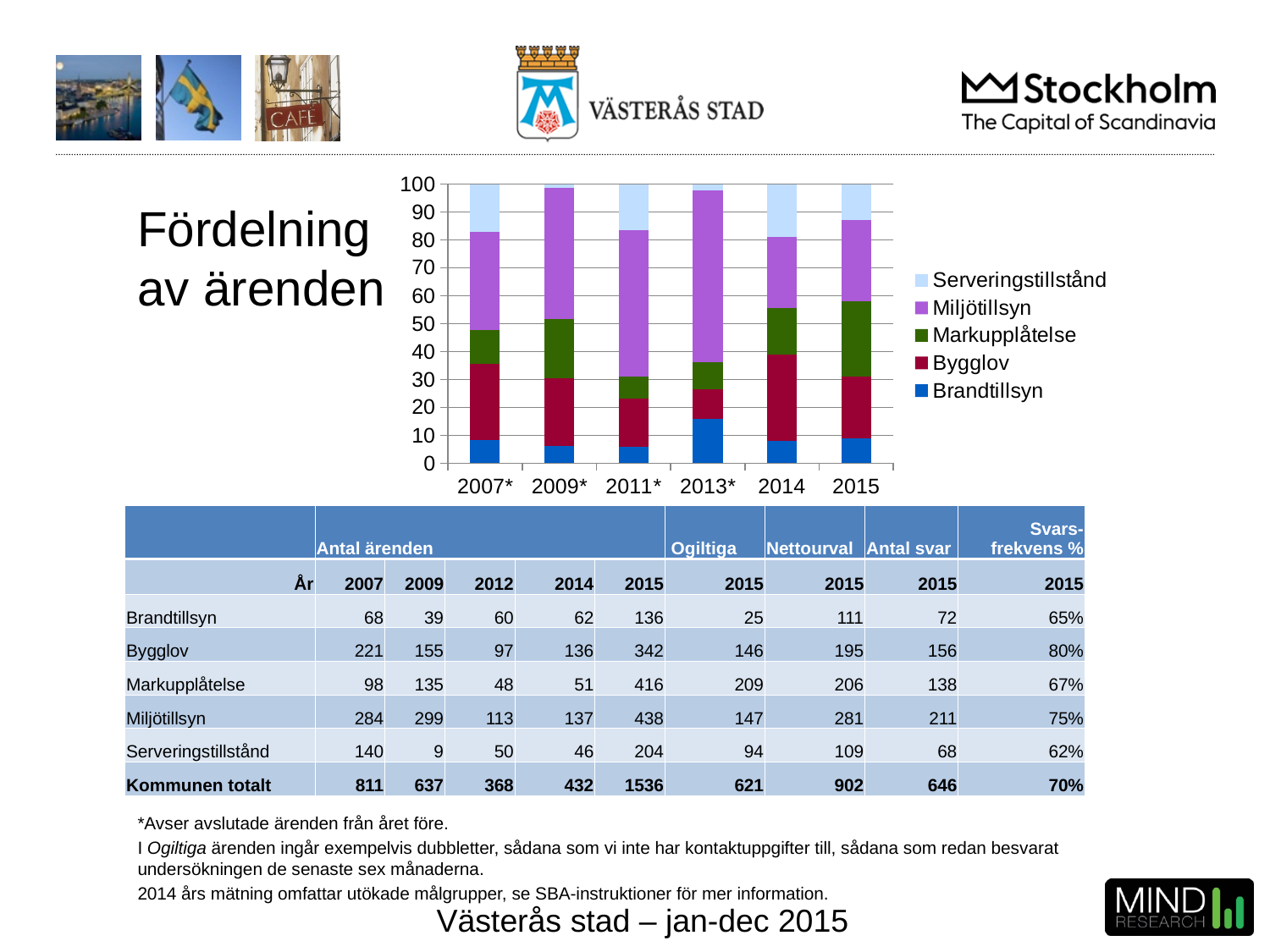
Which series has the largest share in 2013*? Miljötillsyn Is the Miljötillsyn value for 2013* greater or less than 50? greater What kind of chart is shown on the slide? Stacked bar chart How many series does the chart legend list? 5 Is the Brandtillsyn value for 2013* greater or less than 10? greater What is the title of the chart? Fördelning av ärenden Which series is shown in blue at the bottom of each bar? Brandtillsyn Is the Miljötillsyn share larger in 2013* or in 2014? 2013* How many years (categories) are shown along the x axis of the chart? 6 Which year has the largest Brandtillsyn share? 2013* Is the Brandtillsyn value for 2011* greater or less than 10? less Which year has the smallest Serveringstillstånd share? 2009*